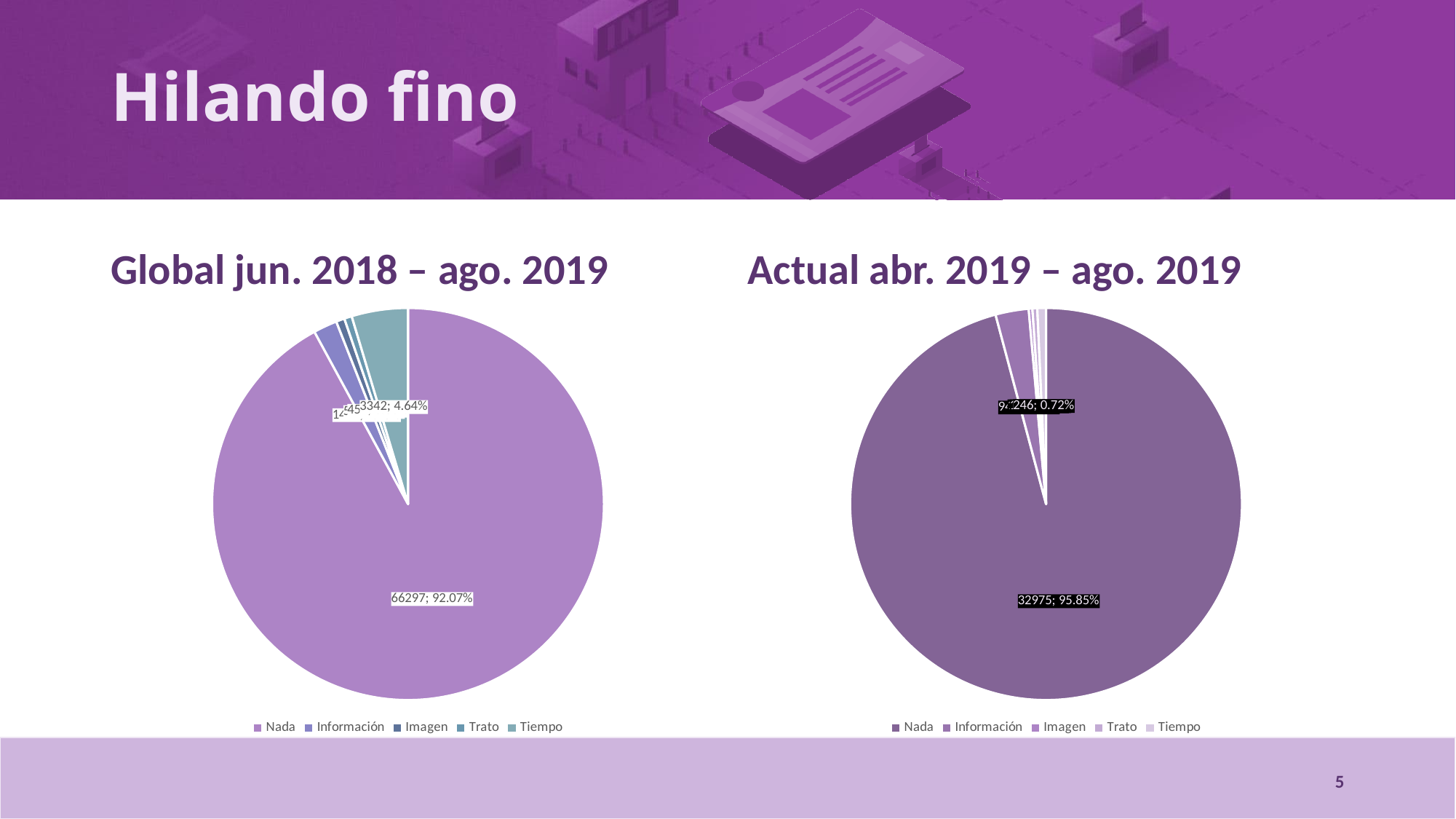
In the 'Global jun. 2018 – ago. 2019' chart, what is the value shown for Tiempo? 3342 In the 'Global jun. 2018 – ago. 2019' chart, what share of the pie does Nada represent? 92.07% How many categories does the legend of the 'Actual abr. 2019 – ago. 2019' chart list? 5 By how many percentage points does the Nada share in the 'Actual abr. 2019 – ago. 2019' chart exceed the Nada share in the 'Global jun. 2018 – ago. 2019' chart? 3.78 In the 'Global jun. 2018 – ago. 2019' chart, which category has the largest slice? Nada In the 'Actual abr. 2019 – ago. 2019' chart, what is the value shown for Nada? 32975 Is the share of Nada larger in the 'Global jun. 2018 – ago. 2019' chart or in the 'Actual abr. 2019 – ago. 2019' chart? Actual abr. 2019 – ago. 2019 In the 'Global jun. 2018 – ago. 2019' chart, what is the value shown for Nada? 66297 What kind of chart is the 'Global jun. 2018 – ago. 2019' chart? pie chart What is the title of the pie chart on the left side of the slide? Global jun. 2018 – ago. 2019 In the 'Actual abr. 2019 – ago. 2019' chart, which category has the largest slice? Nada In the 'Actual abr. 2019 – ago. 2019' chart, what share of the pie does Nada represent? 95.85%